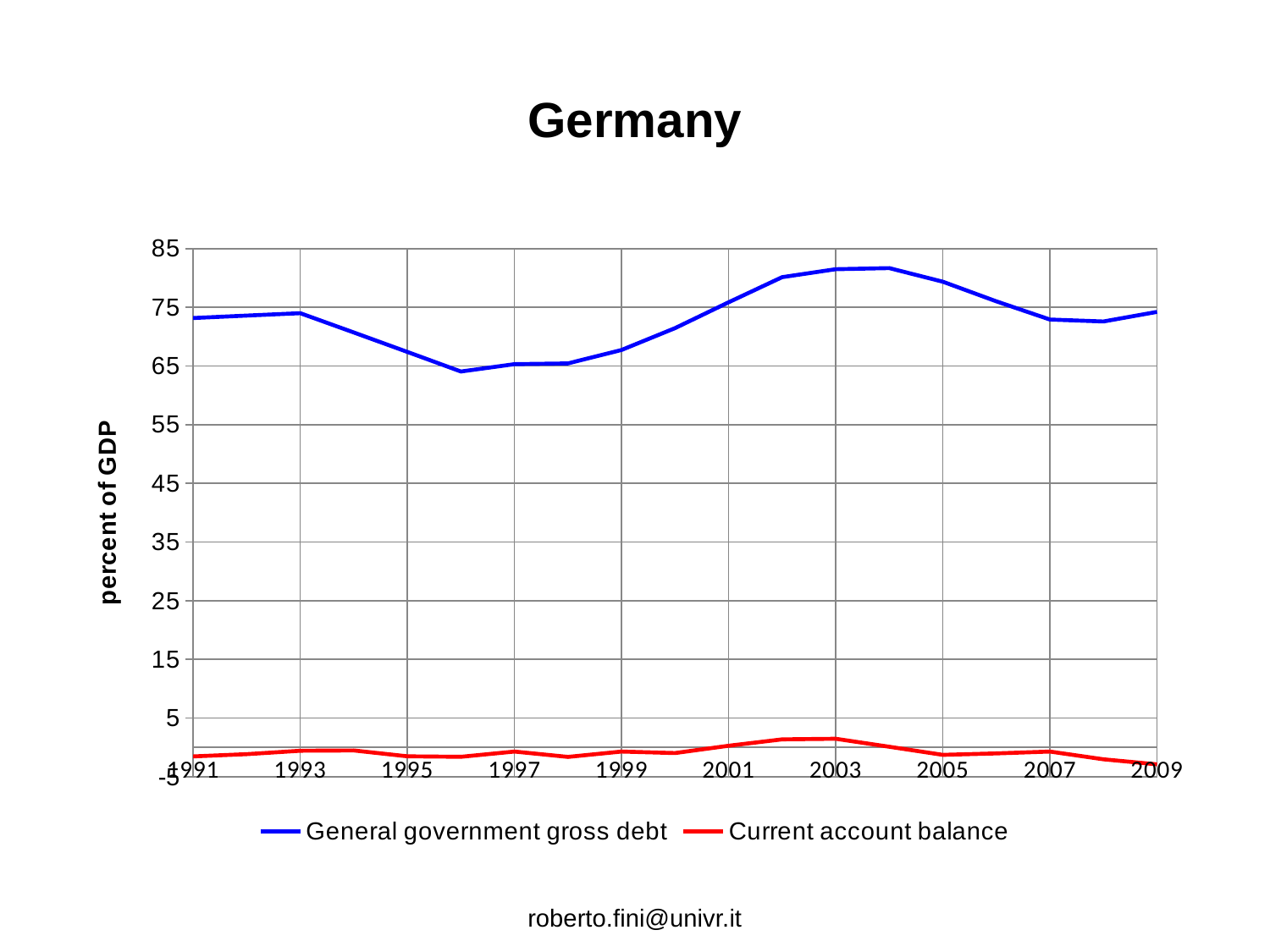
How many series does the legend list? 2 Is the value for Current account balance in 2003 greater or less than 15? less Is the value for General government gross debt in 1996 greater or less than 75? less What kind of chart is shown on the slide? line chart Which is larger, General government gross debt in 2001 or in 1999? 2001 Does General government gross debt rise or fall between 1999 and 2003? rise What is the title of the chart? Germany Does General government gross debt rise or fall between 2004 and 2008? fall Which is larger, General government gross debt in 2003 or in 1996? 2003 What is the label on the vertical axis? percent of GDP How many year labels are shown on the horizontal axis? 10 Is the value for General government gross debt in 2003 greater or less than 75? greater